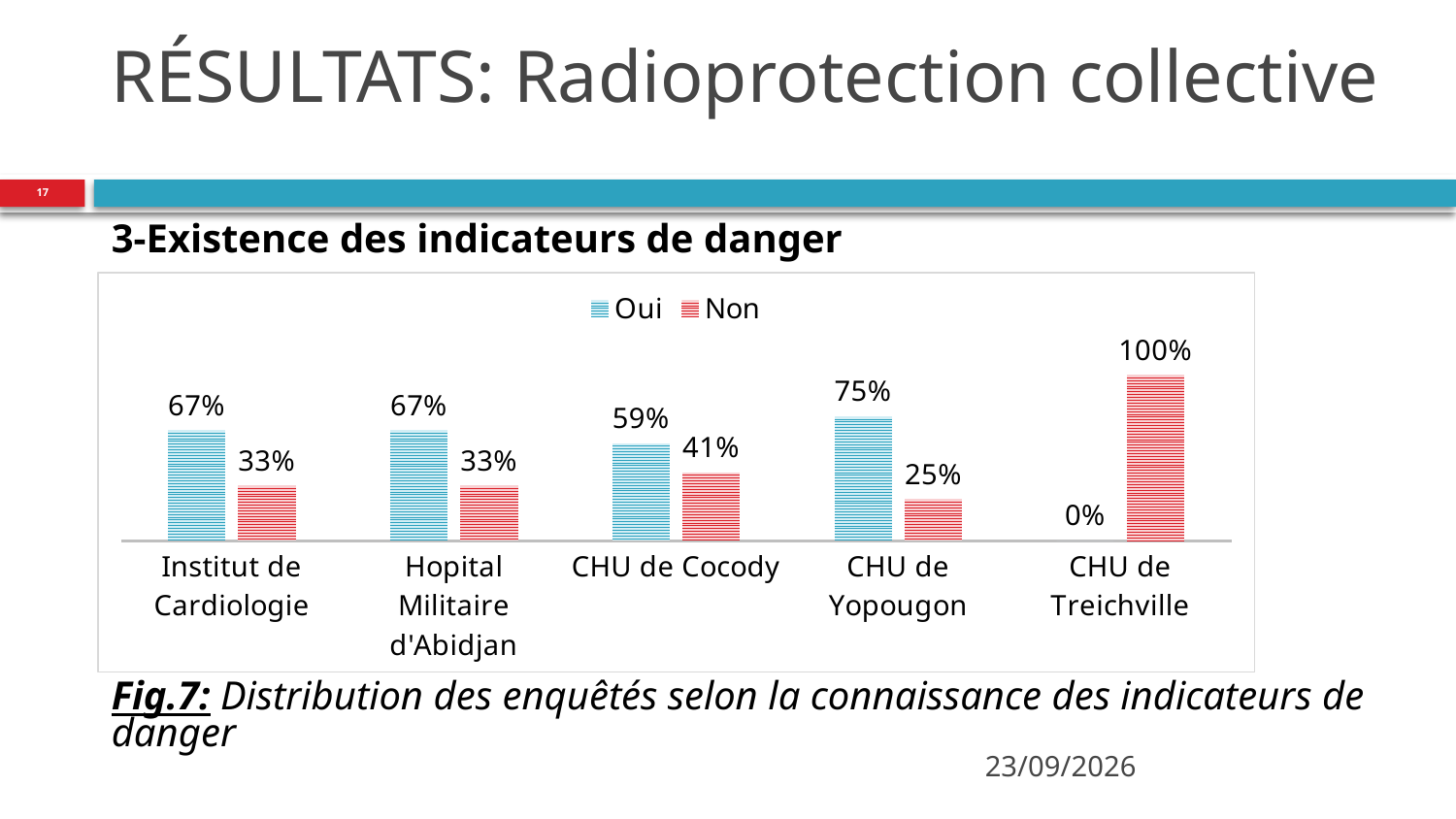
Which hospital has the lowest 'Oui' value? CHU de Treichville What is the 'Oui' value for CHU de Treichville? 0% What is the 'Non' value for Hopital Militaire d'Abidjan? 33% What is the 'Oui' value for CHU de Cocody? 59% Which is larger for CHU de Cocody, the 'Oui' value or the 'Non' value? Oui What are the two series named in the legend? Oui and Non What is the 'Non' value for CHU de Yopougon? 25% What kind of chart is shown? Bar chart How many series does the legend list? 2 How many hospitals are shown on the x axis? 5 Which hospital has the highest 'Non' value? CHU de Treichville What is the difference between the 'Oui' and 'Non' values for CHU de Yopougon? 50%